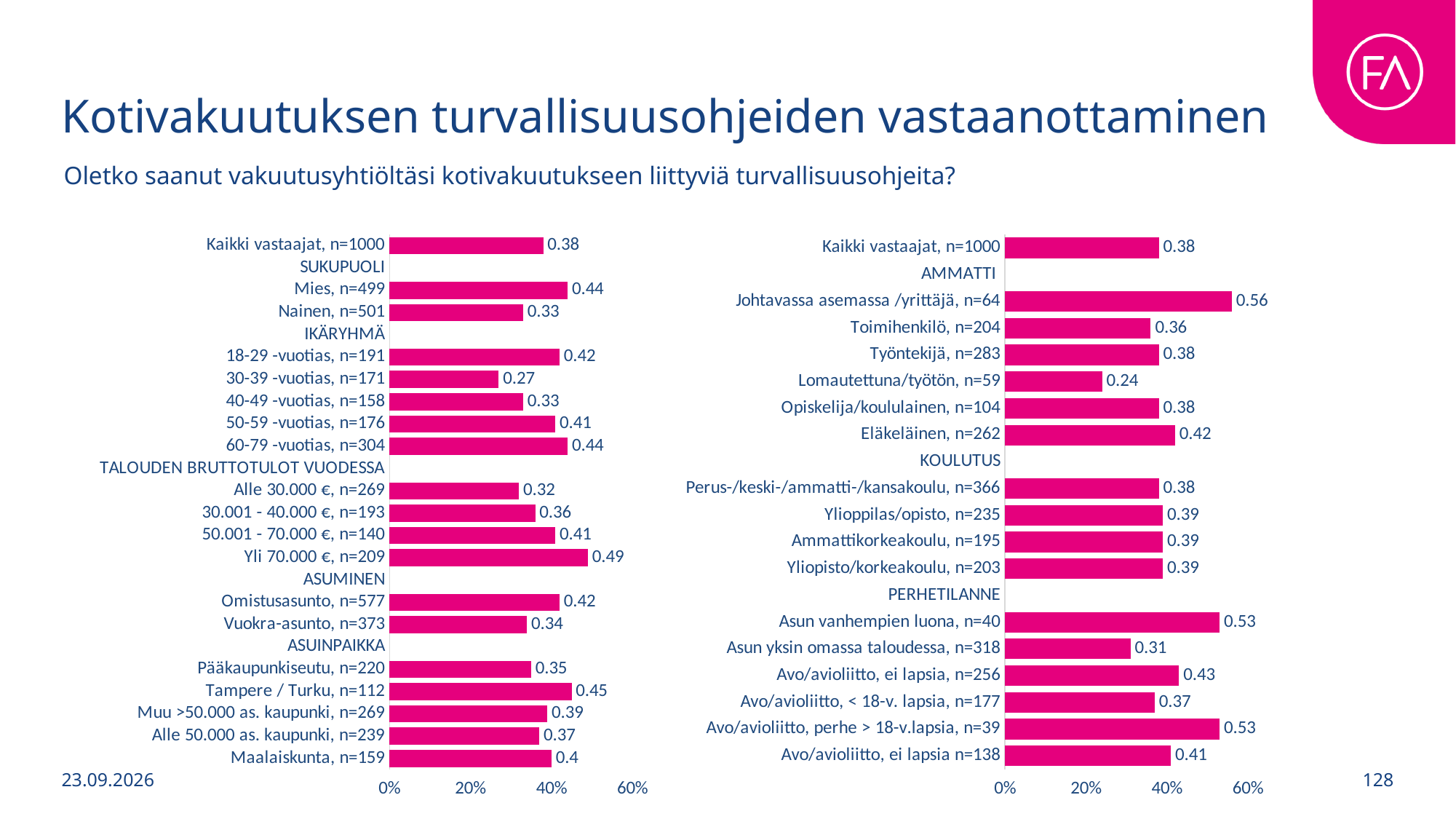
In the right chart, what is the value for Kaikki vastaajat, n=1000? 0.38 What kind of chart is the left chart? bar chart In the right chart, what is the value for Lomautettuna/työtön, n=59? 0.24 In the right chart, which category has the highest value? Johtavassa asemassa /yrittäjä, n=64 In the left chart, which category has the highest value? Yli 70.000 €, n=209 In the left chart, what is the difference between the values for Mies, n=499 and Nainen, n=501? 0.11 In the right chart, which is larger: the value for Eläkeläinen, n=262 or the value for Toimihenkilö, n=204? Eläkeläinen, n=262 In the right chart, what is the difference between the values for Asun vanhempien luona, n=40 and Asun yksin omassa taloudessa, n=318? 0.22 In the right chart, which category has the lowest value? Lomautettuna/työtön, n=59 In the left chart, which category has the lowest value? 30-39 -vuotias, n=171 In the left chart, what is the value for Mies, n=499? 0.44 In the left chart, is the value for Tampere / Turku, n=112 greater or less than 40%? greater